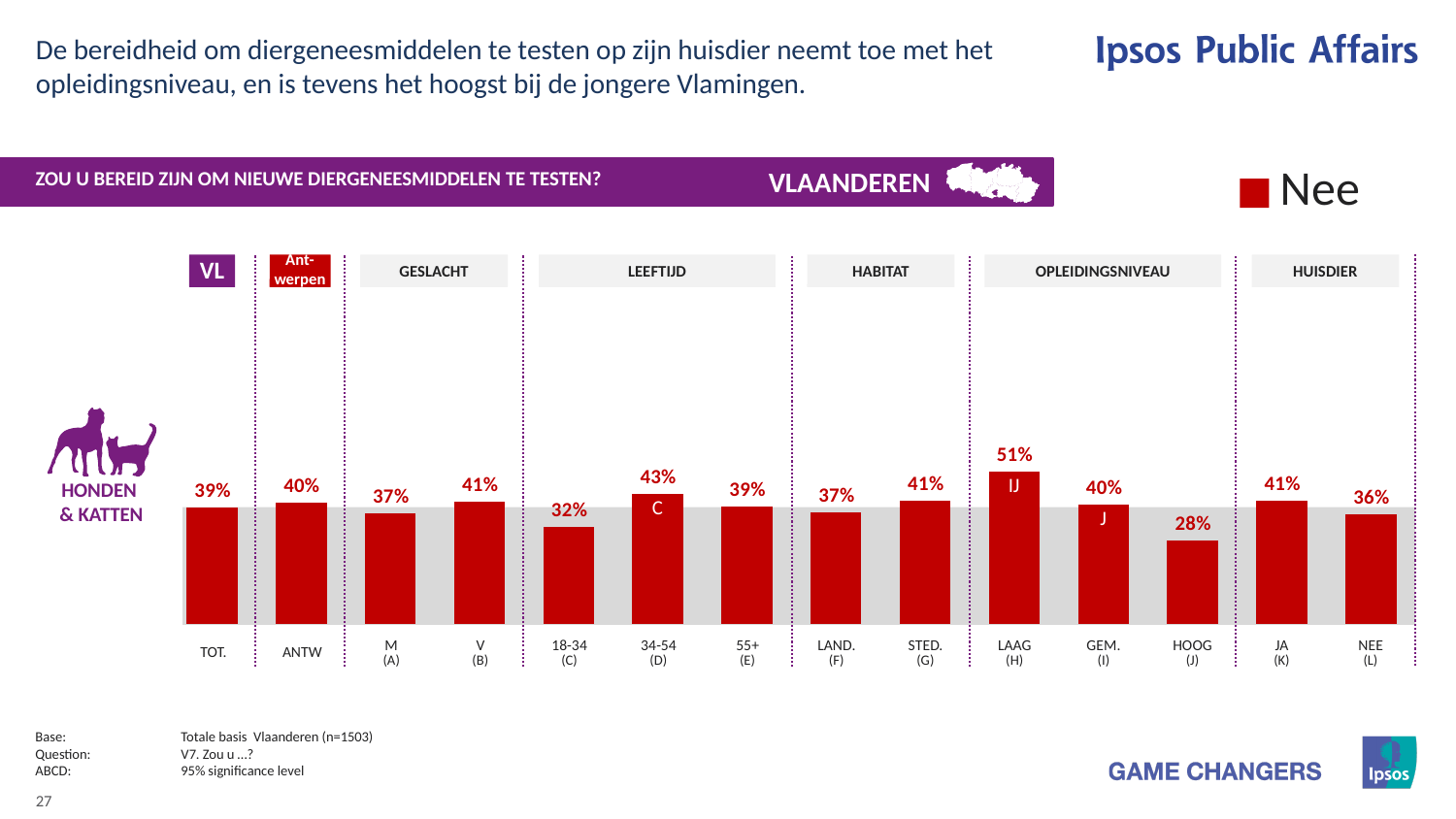
Which category has the highest value? LAAG (H) What is the difference between the values for JA (K) and NEE (L)? 5% What is the legend entry shown for the series? Nee What is the difference between the values for LAAG (H) and HOOG (J)? 23% What is the value for TOT.? 39% What is the value for HOOG (J) under OPLEIDINGSNIVEAU? 28% Which category has the lowest value? HOOG (J) What kind of chart is shown on the slide? Bar chart What is the value for the 18-34 (C) age group? 32% Which is larger, the value for M (A) or the value for V (B)? V (B) How many bars are plotted in the chart? 14 How many series does the legend list? 1